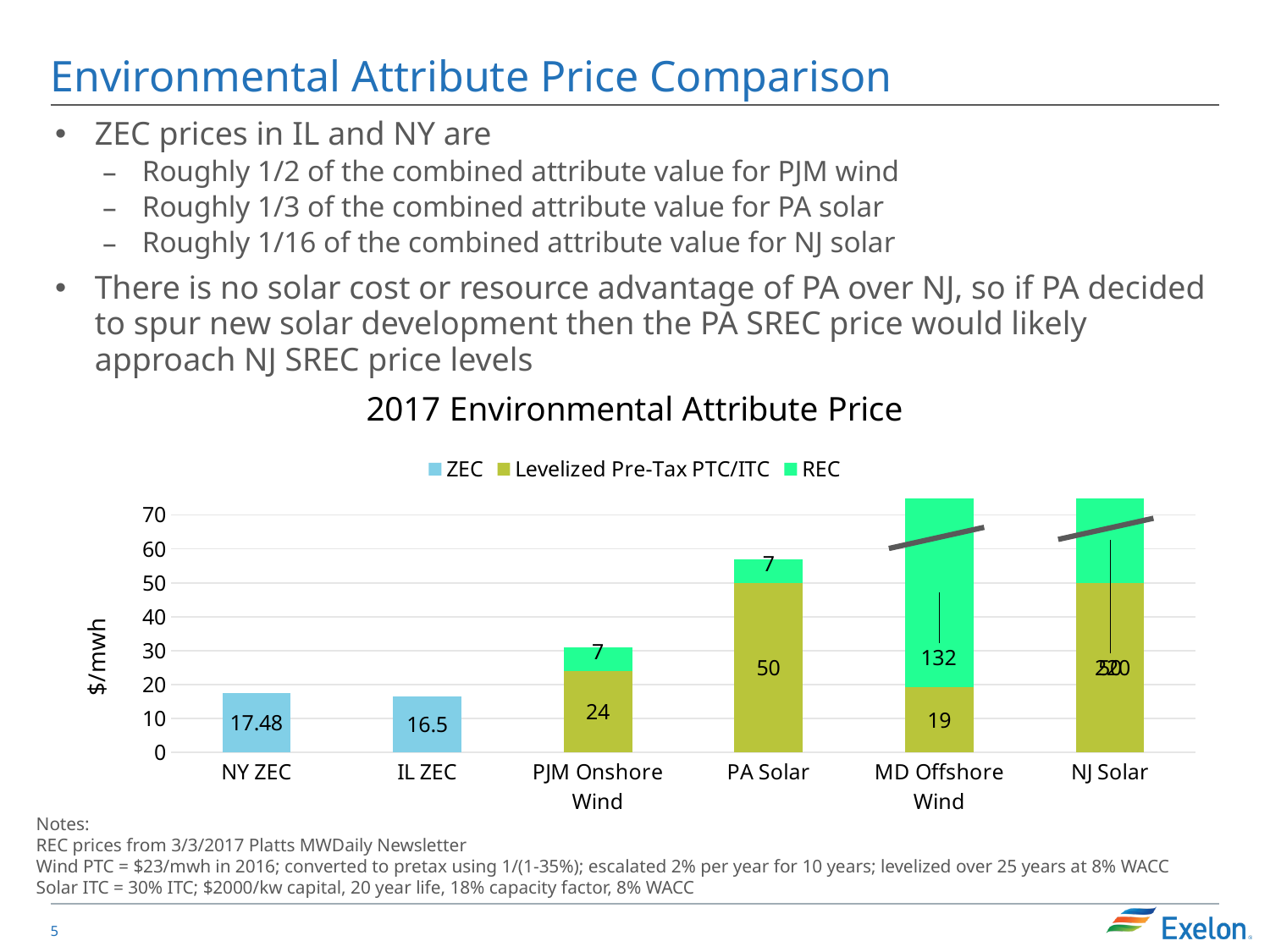
How many categories are shown on the x axis of the chart? 6 What is the REC value for MD Offshore Wind? 132 How many series does the legend of the 2017 Environmental Attribute Price chart list? 3 What is the Levelized Pre-Tax PTC/ITC value for PJM Onshore Wind? 24 What is the ZEC value for NY ZEC? 17.48 What is the total of the stacked bar for PJM Onshore Wind? 31 What is the total of the stacked bar for PA Solar? 57 What is the difference between the NY ZEC and IL ZEC values? 0.98 What is the ZEC value for IL ZEC? 16.5 What is the label on the y axis of the chart? $/mwh What kind of chart is shown on the slide? Stacked bar chart Which is larger, the NY ZEC value or the IL ZEC value? NY ZEC